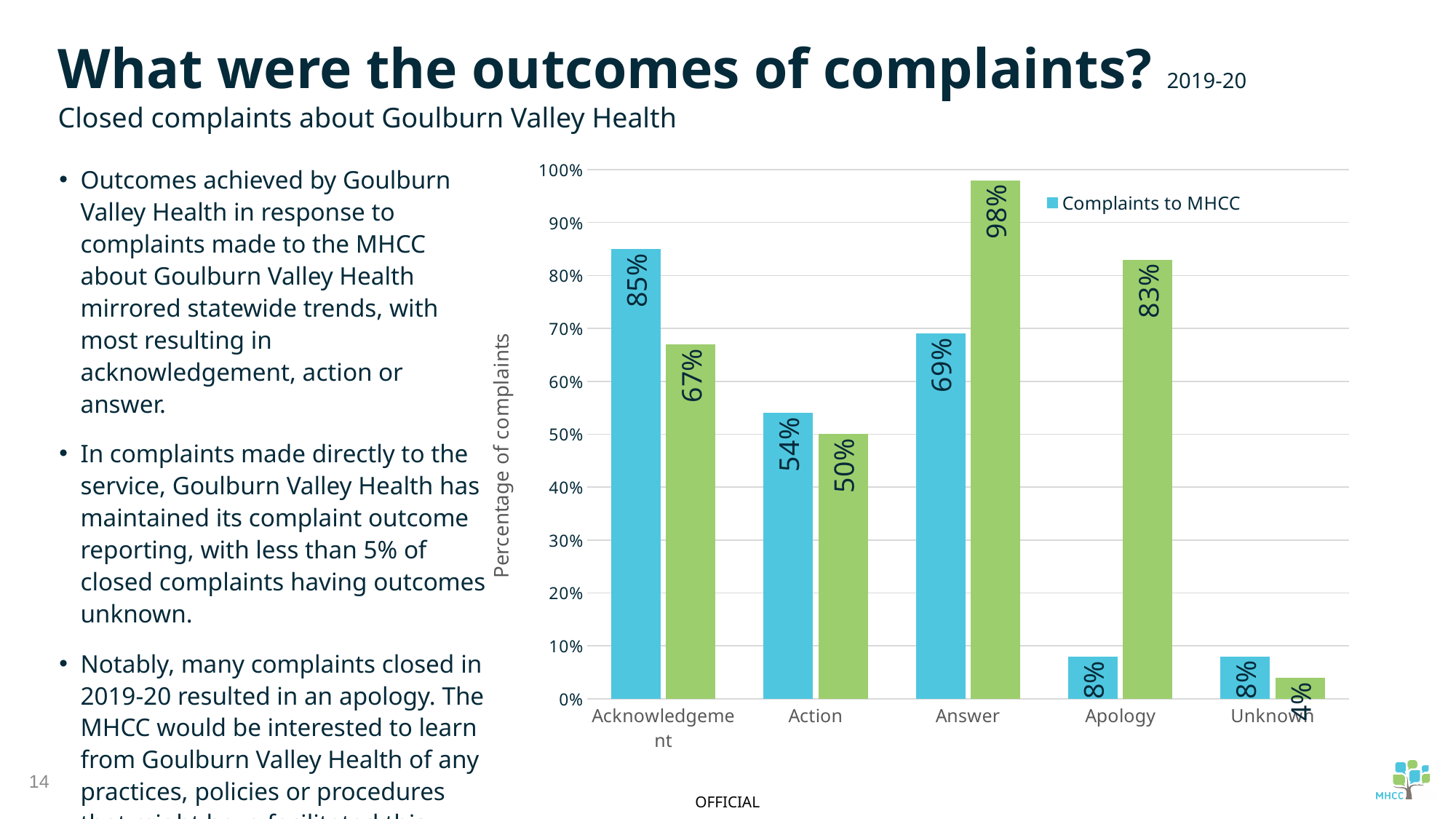
What is the value of Complaints to MHCC for Acknowledgement? 85% For Action, which is larger: the Complaints to MHCC bar or the green bar? Complaints to MHCC Which category has the lowest green bar? Unknown What kind of chart is shown on the slide? Bar chart How many categories are shown on the x axis? 5 What is the value of the green bar for Unknown? 4% How many series does the legend list? 1 What is the difference between the Complaints to MHCC value and the green bar value for Acknowledgement? 18 percentage points Which category has the highest value for Complaints to MHCC? Acknowledgement What is the value of Complaints to MHCC for Apology? 8% What is the value of the green bar for Answer? 98% Which category has the highest green bar? Answer